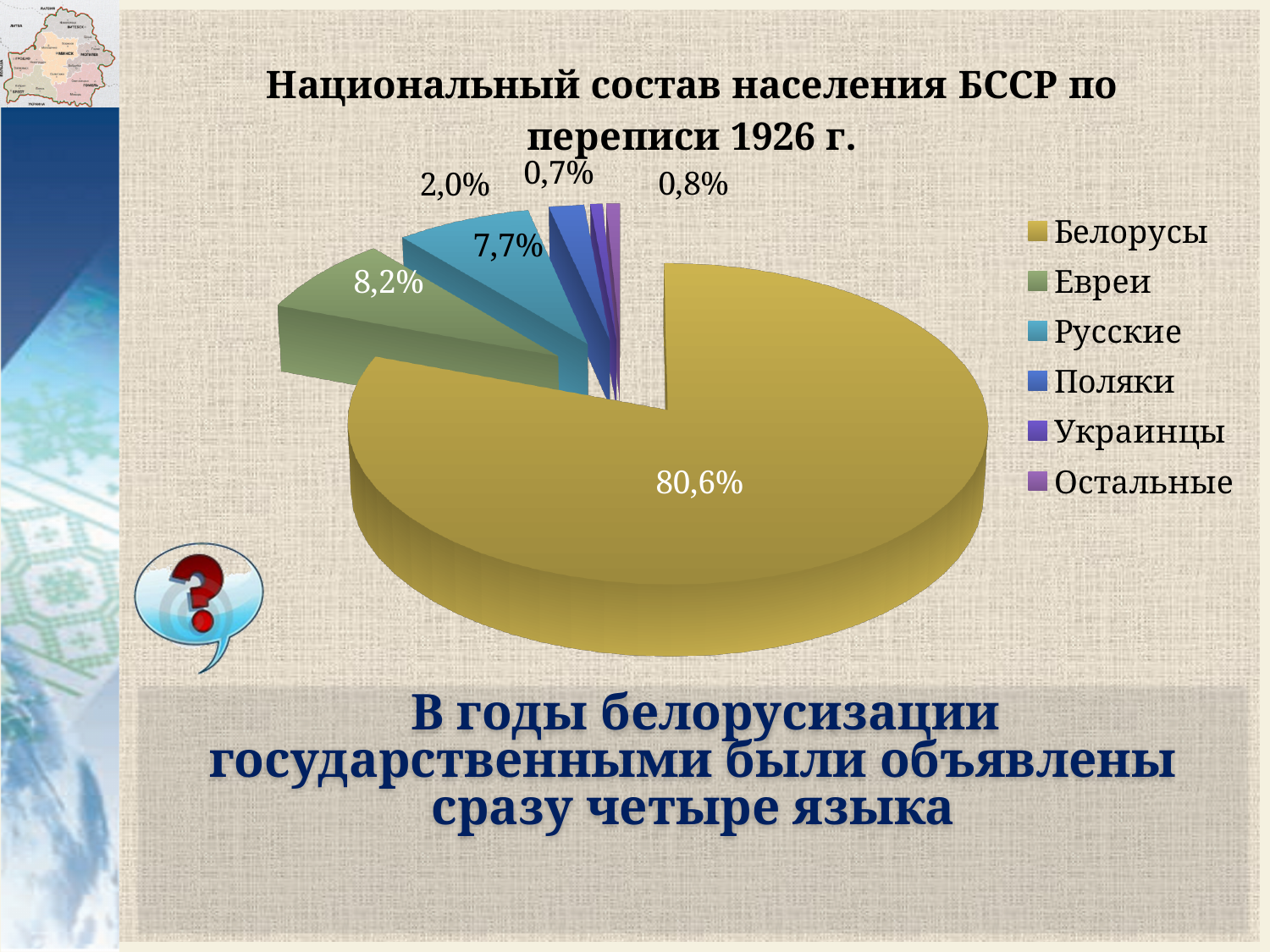
What share of the pie is labelled for Поляки? 2,0% What is the title of the chart? Национальный состав населения БССР по переписи 1926 г. What kind of chart is shown on the slide? pie chart What share of the pie is labelled for Евреи? 8,2% What share of the pie is labelled for Белорусы? 80,6% What is the difference between the shares for Белорусы and Евреи? 72,4% How many categories does the legend of the pie chart list? 6 Which category has the largest slice of the pie? Белорусы Which category has the smallest slice of the pie? Украинцы What share of the pie is labelled for Русские? 7,7% Which slice is larger, Евреи or Русские? Евреи Which colour represents Белорусы in the pie chart? yellow